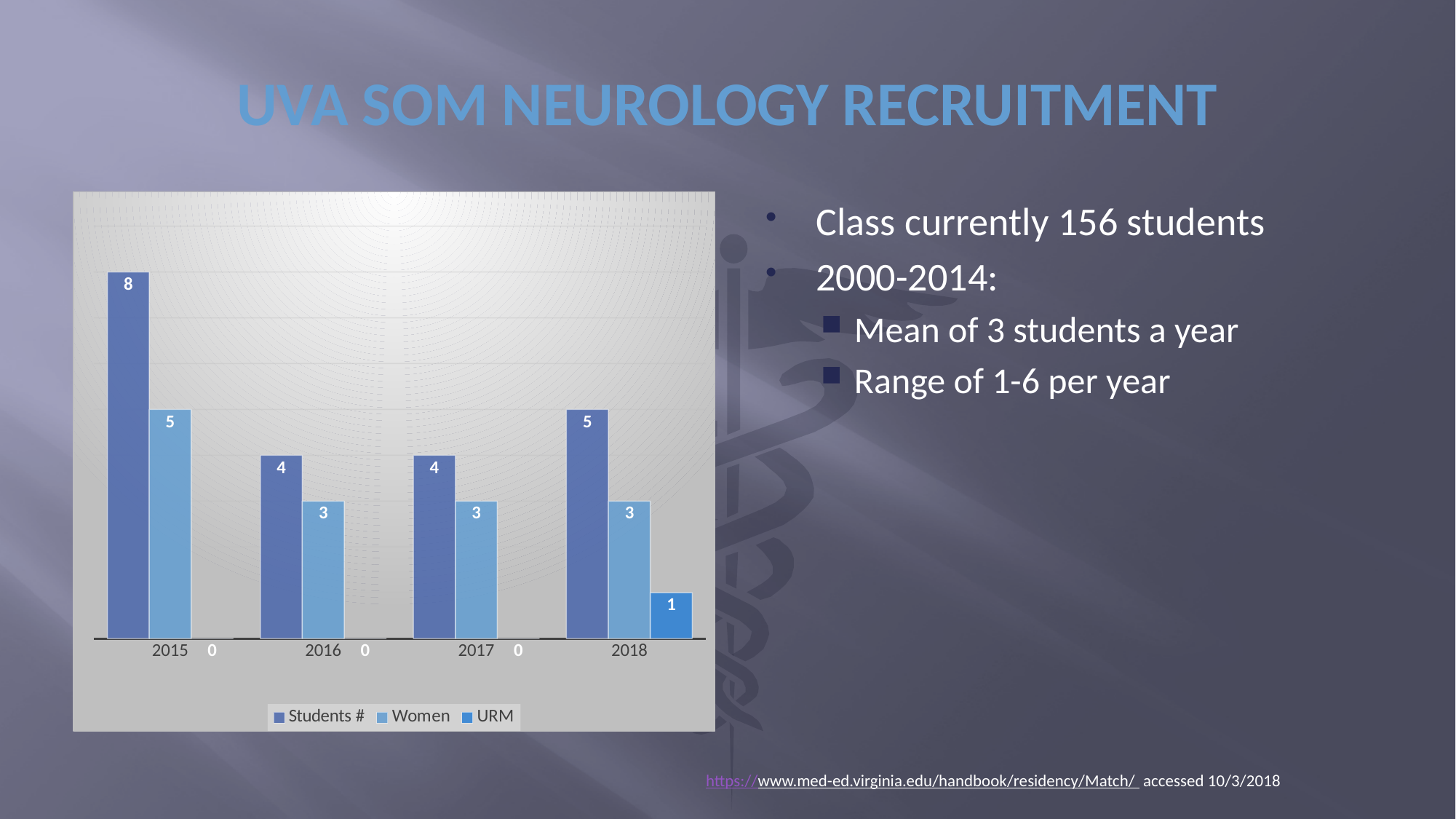
Which year has the lowest value for Women? 2016, 2017 and 2018 (all 3) What is the difference between Students # and Women in 2015? 3 Which year has the highest value for Students #? 2015 What kind of chart is shown on the slide? Bar chart What is the value for URM in 2018? 1 Is the value for Students # in 2018 larger than the value for Students # in 2017? Yes, 2018 (5) is larger than 2017 (4) What is the value for Students # in 2015? 8 How many years are shown on the x axis? 4 What are the three series listed in the legend? Students #, Women, URM How many series does the legend list? 3 What is the value for URM in 2016? 0 What is the value for Women in 2018? 3